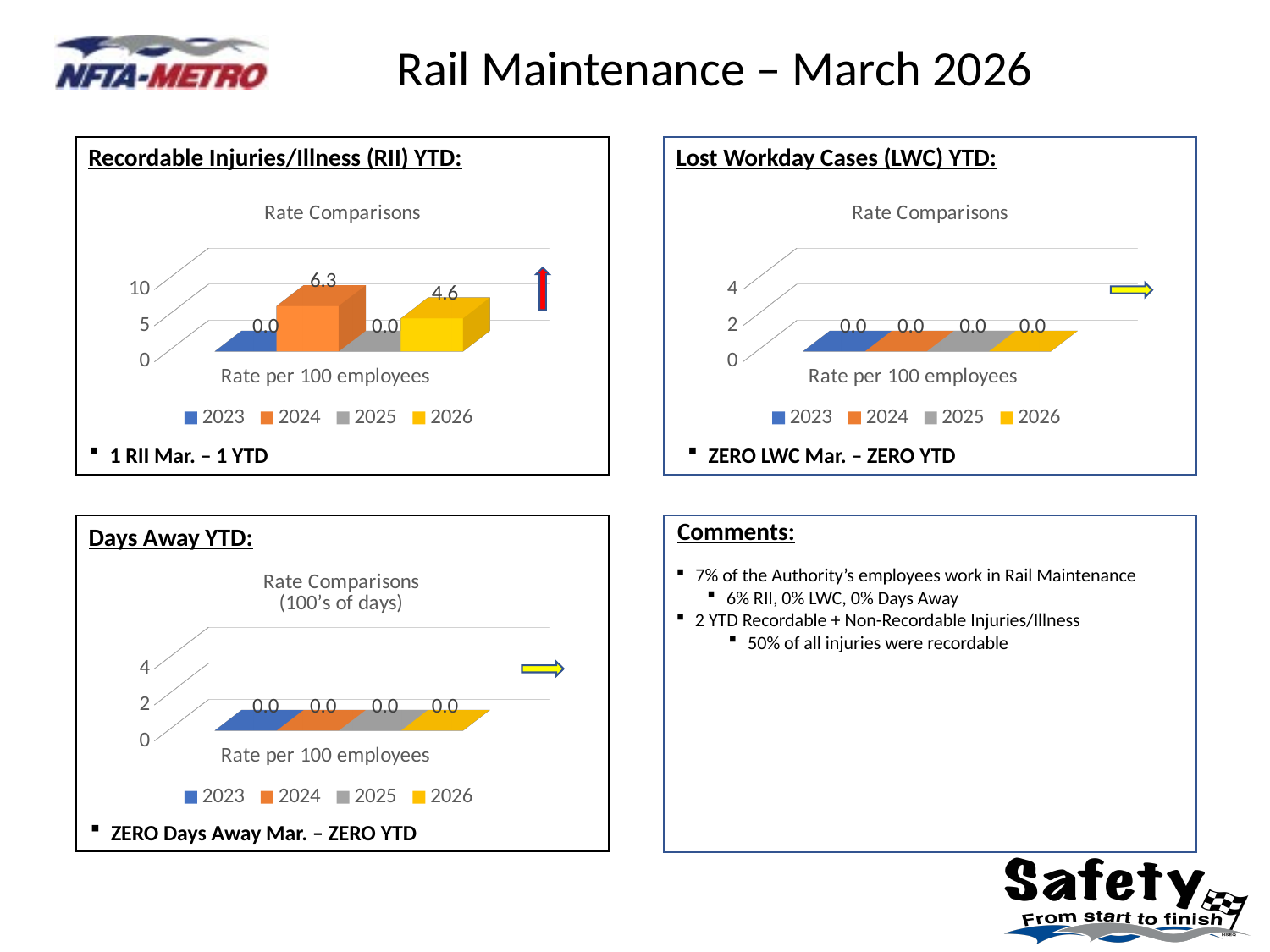
In the Recordable Injuries/Illness (RII) YTD chart, what is the difference between the 2024 and 2026 values? 1.7 In the Recordable Injuries/Illness (RII) YTD chart, which year has the highest rate? 2024 What kind of chart is the Days Away YTD chart? Bar chart In the Recordable Injuries/Illness (RII) YTD chart, is the value for 2024 greater or less than 5? greater In the Recordable Injuries/Illness (RII) YTD chart, what is the value for 2026? 4.6 In the Recordable Injuries/Illness (RII) YTD chart, what is the value for 2023? 0.0 How many series does the legend list in the Lost Workday Cases (LWC) YTD chart? 4 In the Lost Workday Cases (LWC) YTD chart, what is the value for 2025? 0.0 In the Recordable Injuries/Illness (RII) YTD chart, what is the value for 2024? 6.3 In the Days Away YTD chart, what is the value for 2026? 0.0 In the Recordable Injuries/Illness (RII) YTD chart, which is larger, the value for 2024 or the value for 2026? 2024 What is the x-axis label of the Recordable Injuries/Illness (RII) YTD chart? Rate per 100 employees